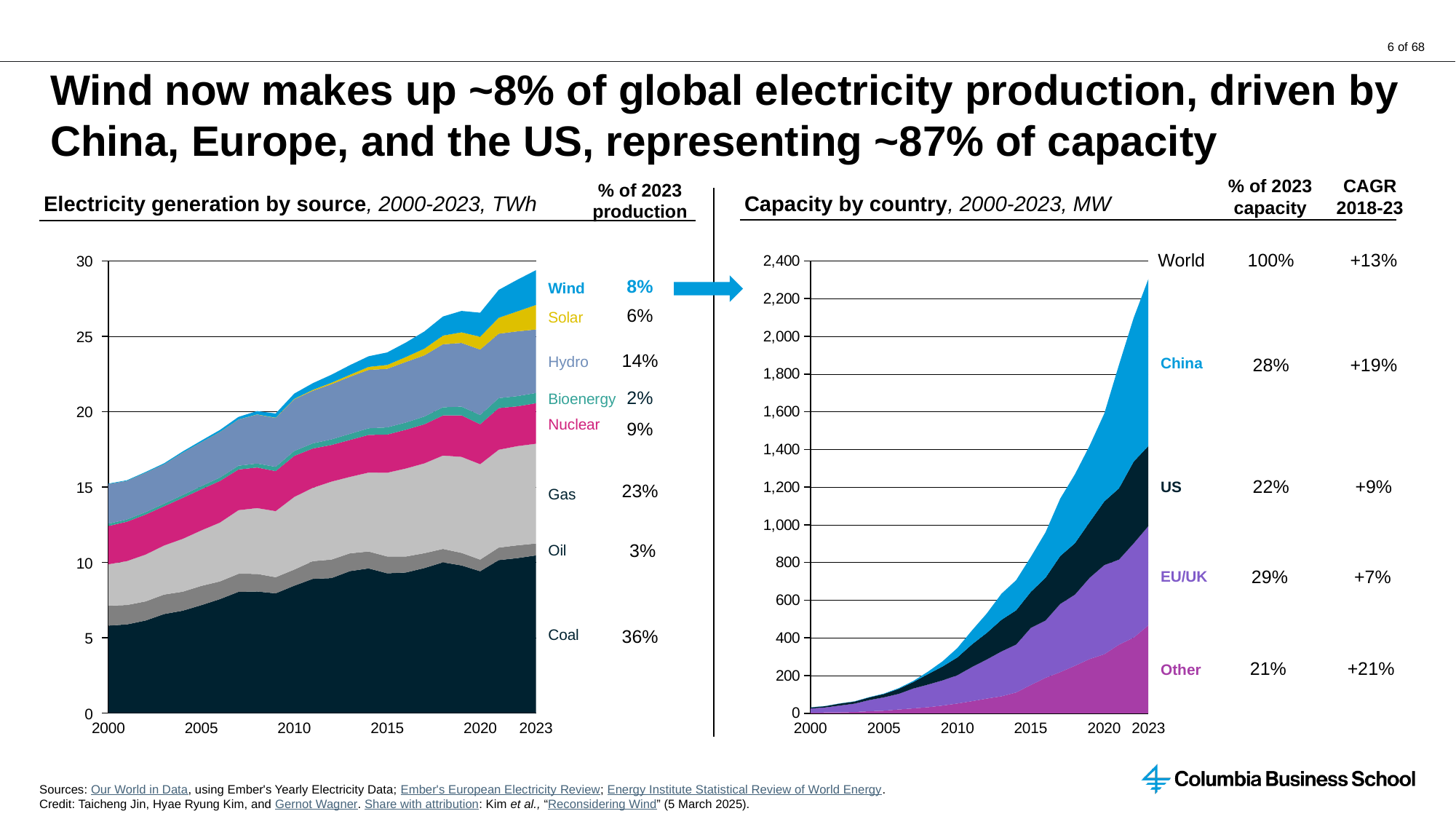
In the 'Electricity generation by source' chart, which has a larger share of 2023 production, Solar or Oil? Solar How many electricity sources are shown in the 'Electricity generation by source' chart? 8 In the 'Electricity generation by source' chart, what is the difference between the 2023 production shares of Gas and Hydro? 9 percentage points In the 'Capacity by country' chart, what is China's share of 2023 capacity? 28% In the 'Electricity generation by source' chart, which source has the largest share of 2023 production? Coal In the 'Electricity generation by source' chart, does total electricity generation rise or fall from 2000 to 2023? Rise In the 'Capacity by country' chart, which region has the highest CAGR for 2018-23? Other In the 'Electricity generation by source' chart, which source has the smallest share of 2023 production? Bioenergy In the 'Electricity generation by source' chart, what percentage of 2023 production does Coal account for? 36% In the 'Capacity by country' chart, is the total world capacity in 2023 greater or less than 2,000 MW? greater In the 'Electricity generation by source' chart, what percentage of 2023 production does Wind account for? 8% What kind of chart is the 'Capacity by country' chart? Stacked area chart